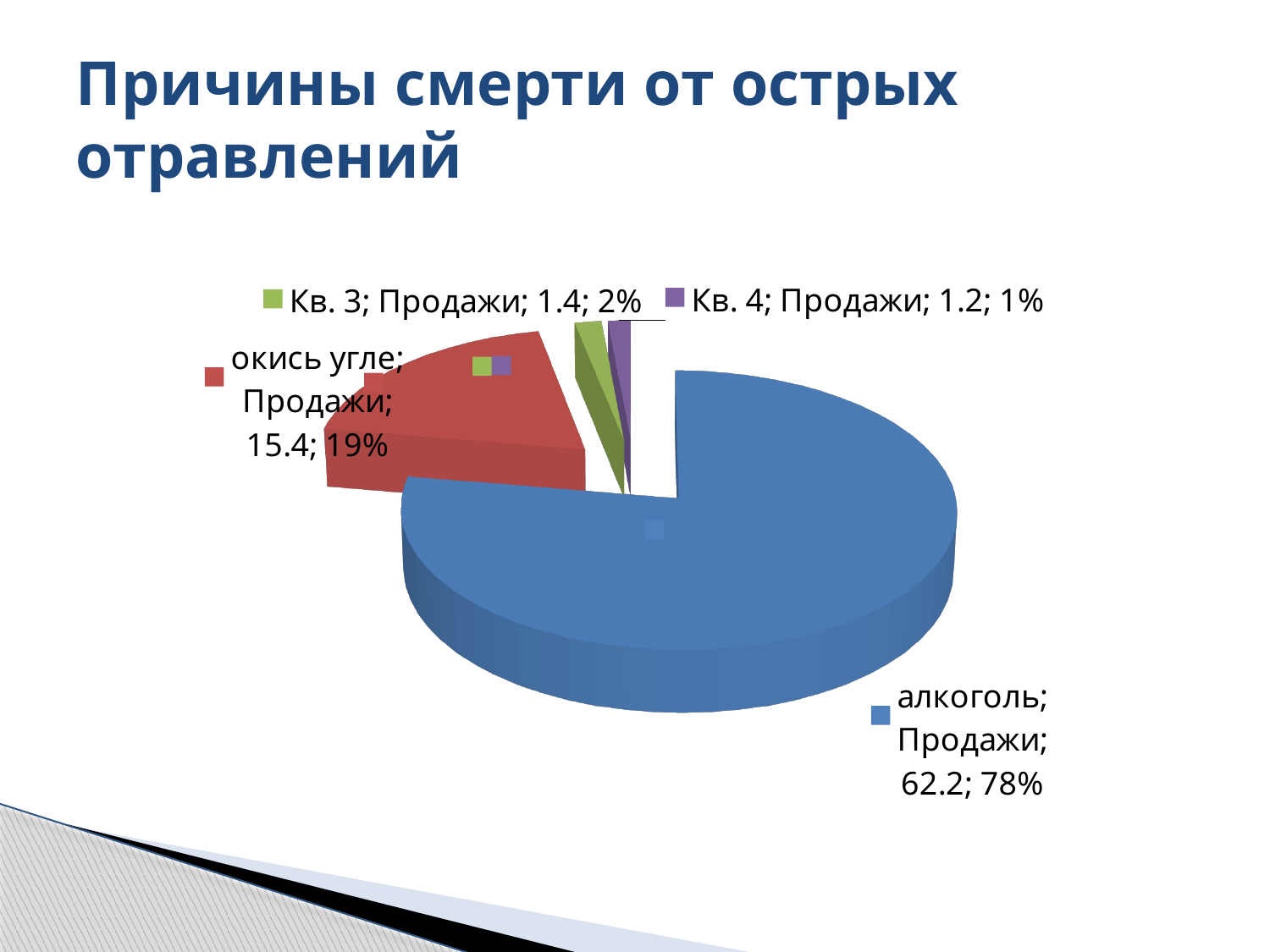
How many slices does the pie chart have? 4 What share of the pie does алкоголь take? 78% What is the value for Кв. 4? 1.2 What share of the pie does окись угле take? 19% What is the title of the slide containing the chart? Причины смерти от острых отравлений What is the value for окись угле? 15.4 What is the difference between the values for алкоголь and окись угле? 46.8 What kind of chart is shown on the slide? pie chart Which category has the largest slice? алкоголь What is the value for Кв. 3? 1.4 Which category has the smallest slice? Кв. 4 What is the value for алкоголь? 62.2